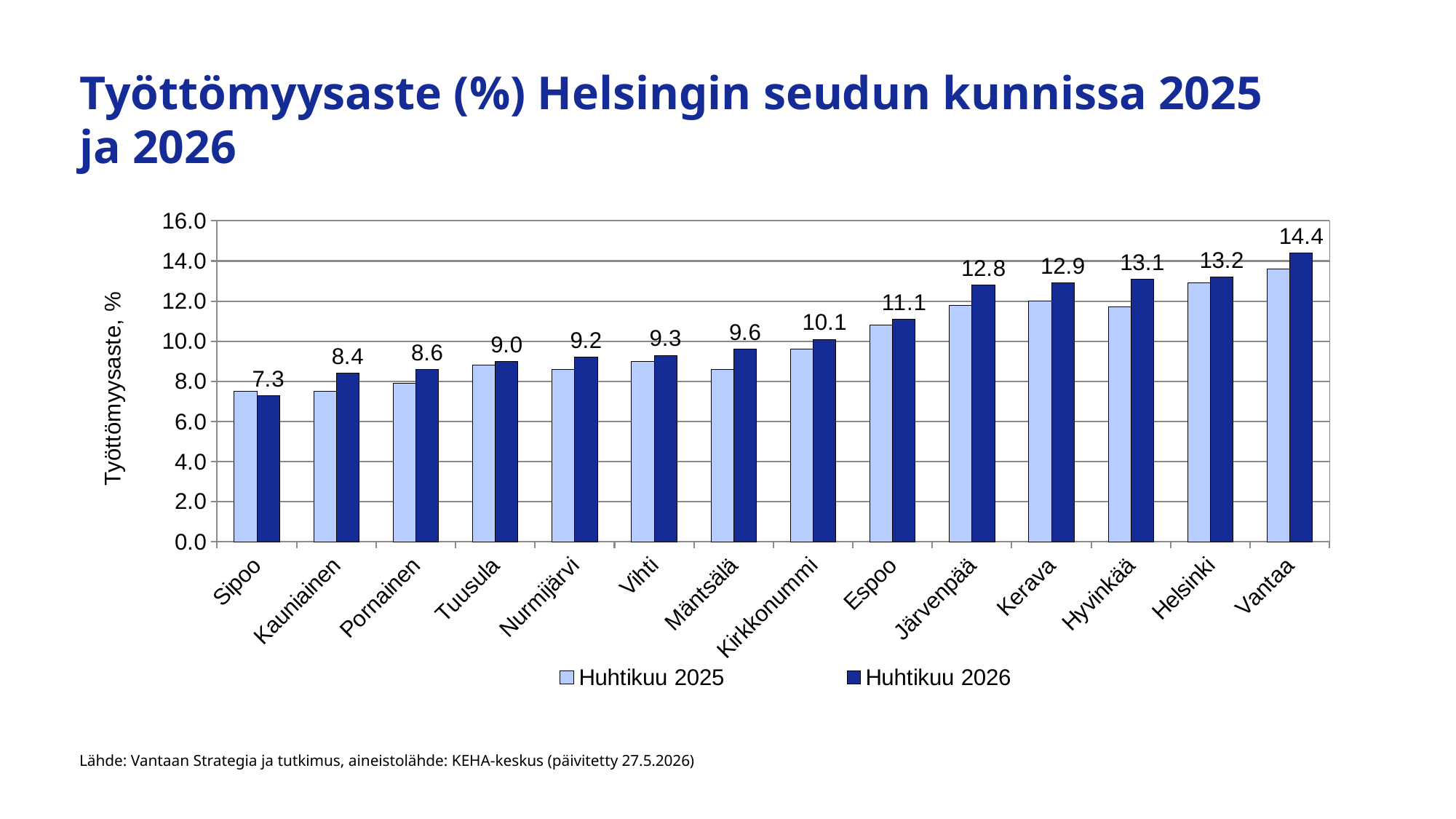
What is the Huhtikuu 2026 value for Espoo? 11.1 Which municipality has the lowest Huhtikuu 2026 unemployment rate? Sipoo What is the unemployment rate for Vantaa in Huhtikuu 2026? 14.4 Which has the larger Huhtikuu 2026 value, Hyvinkää or Espoo? Hyvinkää What is the difference between the Huhtikuu 2026 values for Vantaa and Sipoo? 7.1 What kind of chart is shown on the slide? bar chart How many series does the legend list? 2 Which municipality has the highest Huhtikuu 2026 unemployment rate? Vantaa Is the Huhtikuu 2025 value for Espoo greater or less than 12.0? less Is the Huhtikuu 2025 value for Helsinki greater or less than 12.0? greater How many municipalities are shown on the x axis? 14 What is the unemployment rate for Sipoo in Huhtikuu 2026? 7.3